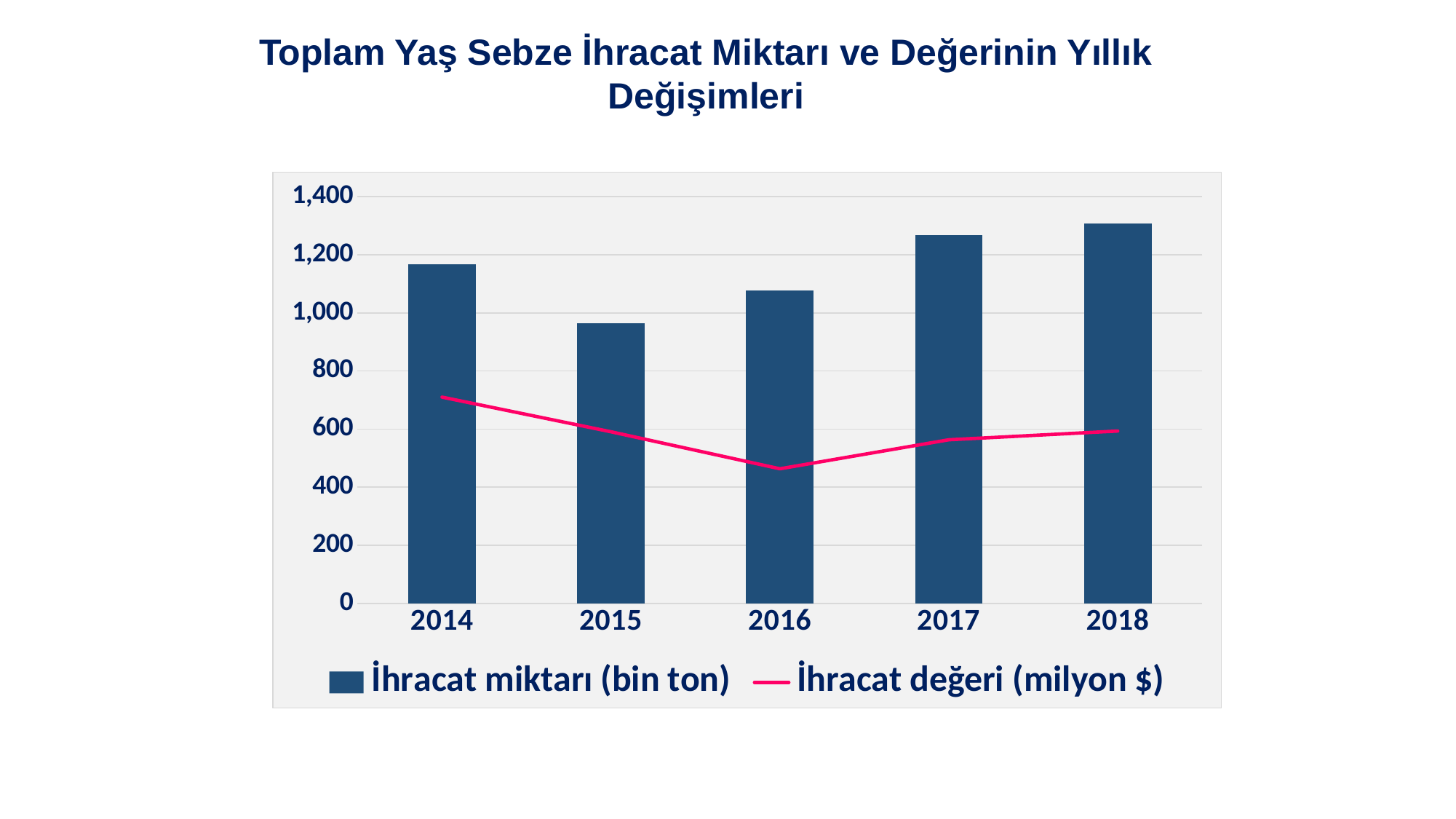
Does the İhracat miktarı (bin ton) series rise or fall from 2015 to 2018? rise Which year has the larger İhracat miktarı (bin ton) bar, 2014 or 2016? 2014 Which year has the highest İhracat miktarı (bin ton) bar? 2018 Which year has the lowest İhracat miktarı (bin ton) bar? 2015 In which year is the İhracat değeri (milyon $) line at its lowest point? 2016 In which year is the İhracat değeri (milyon $) line at its highest point? 2014 Is the İhracat miktarı (bin ton) value for 2018 greater or less than 1,200? greater What kind of chart is shown on the slide? A bar chart combined with a line chart Is the İhracat değeri (milyon $) value for 2016 greater or less than 600? less Is the İhracat miktarı (bin ton) value for 2015 greater or less than 1,000? less How many series does the legend list? 2 How many years are shown on the x axis? 5